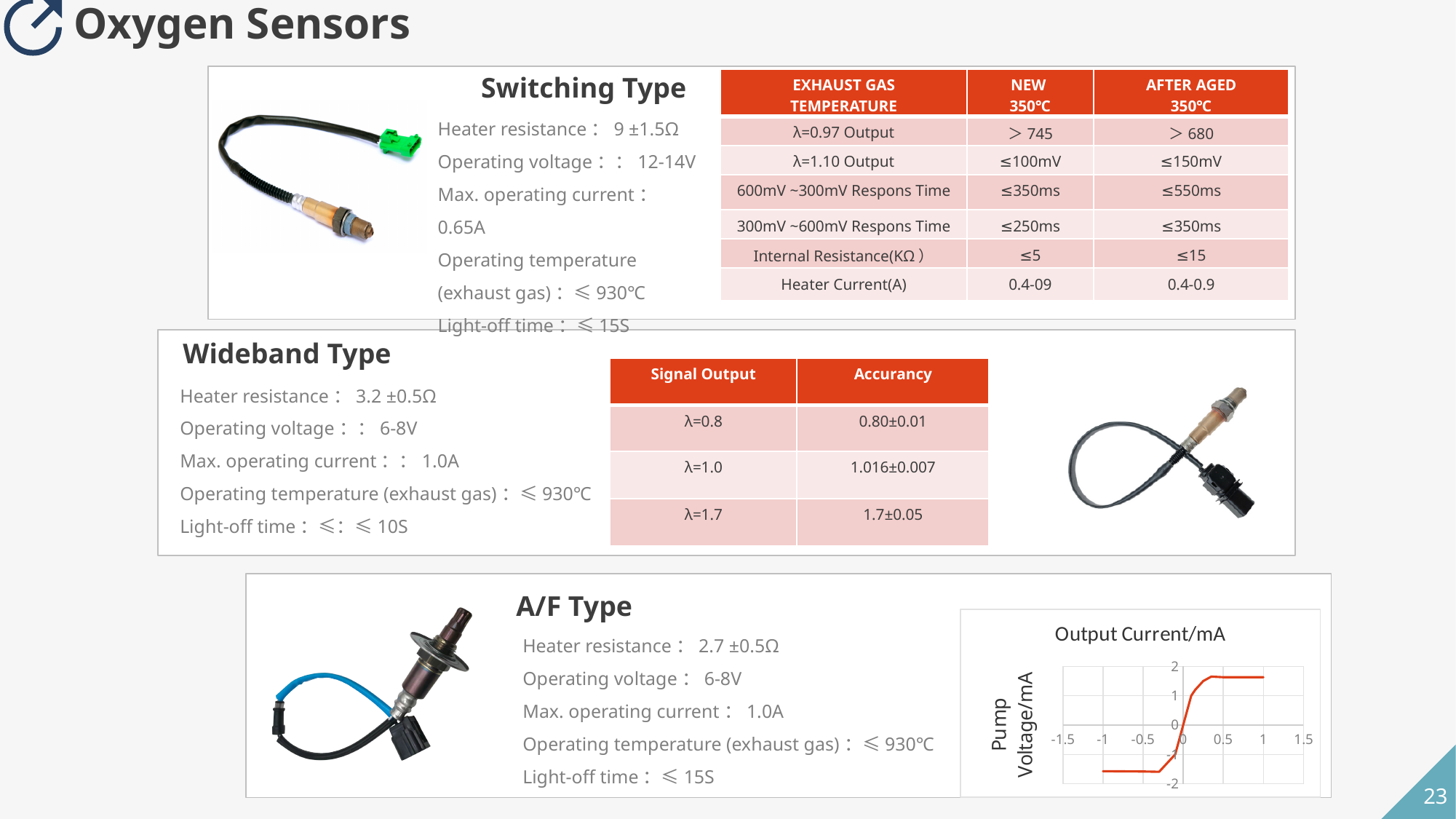
In the Output Current/mA chart, is the value of the line at x = -0.5 greater or less than -1? less In the Output Current/mA chart, is the value of the line at x = 0.5 greater or less than 1? greater What is the label on the vertical axis of the Output Current/mA chart? Pump Voltage/mA What kind of chart is shown in the A/F Type section of the slide? line chart In the Output Current/mA chart, which is larger: the value of the line at x = 1 or at x = -1? x = 1 How many plotted lines (series) are drawn in the Output Current/mA chart? 1 In the Output Current/mA chart, does the plotted line rise or fall as the x-axis value increases from -1.5 to 1.5? rise What is the title of the chart in the A/F Type section? Output Current/mA In the Output Current/mA chart, is the value of the line at x = -1 greater or less than -1? less